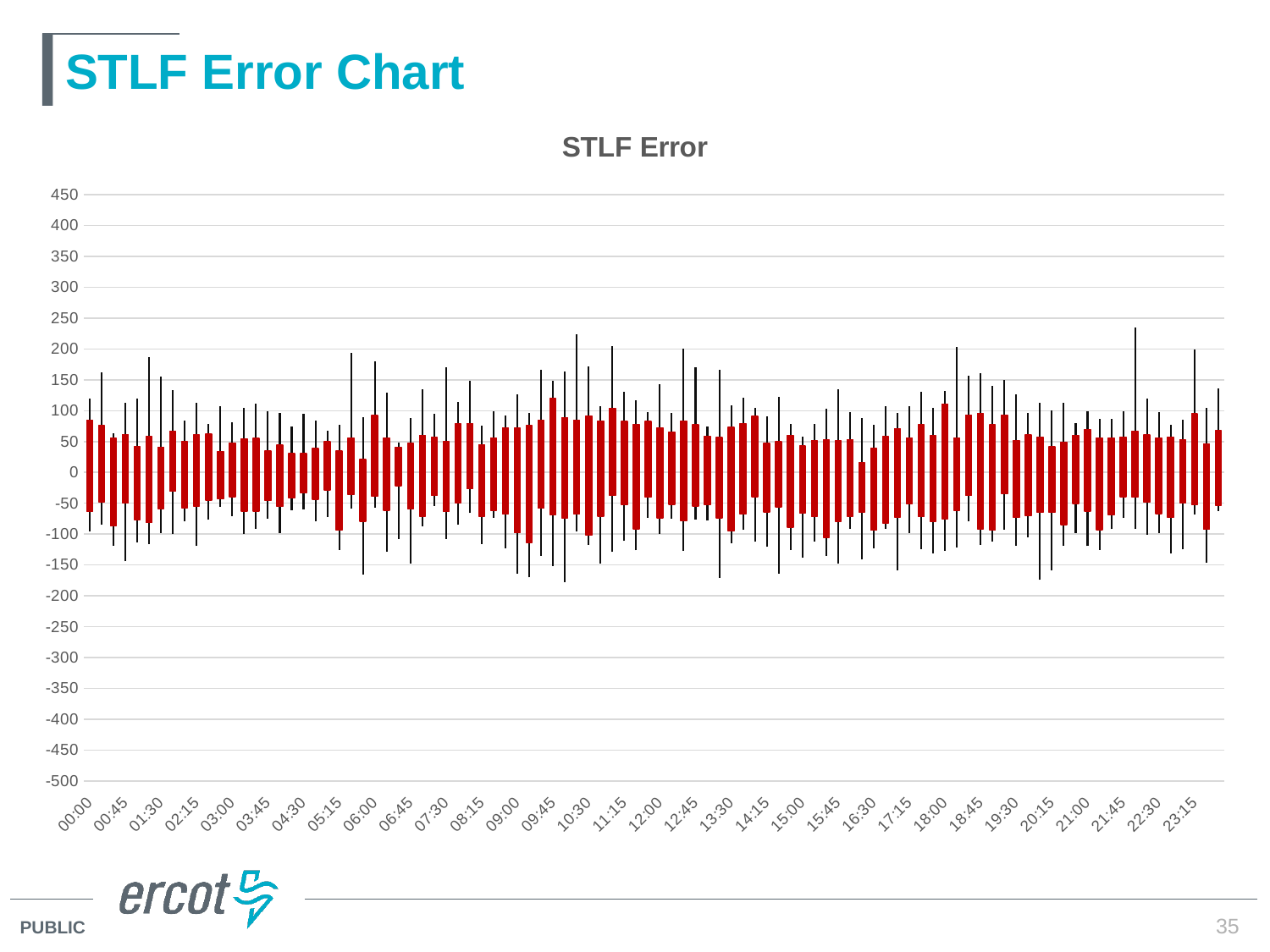
What is the last time label on the horizontal axis? 23:15 What is the first time label on the horizontal axis? 00:00 What is the highest value shown on the vertical axis? 450 What is the lowest value shown on the vertical axis? -500 Is the highest point reached by any whisker on the chart greater or less than 200? greater Is the lowest point reached by any whisker on the chart greater or less than -150? less What is the interval between consecutive gridlines on the vertical axis? 50 How many time labels are printed along the horizontal axis? 32 What is the title of the chart? STLF Error Is the highest whisker on the chart located in the first half of the day (before 12:00) or the second half? second half